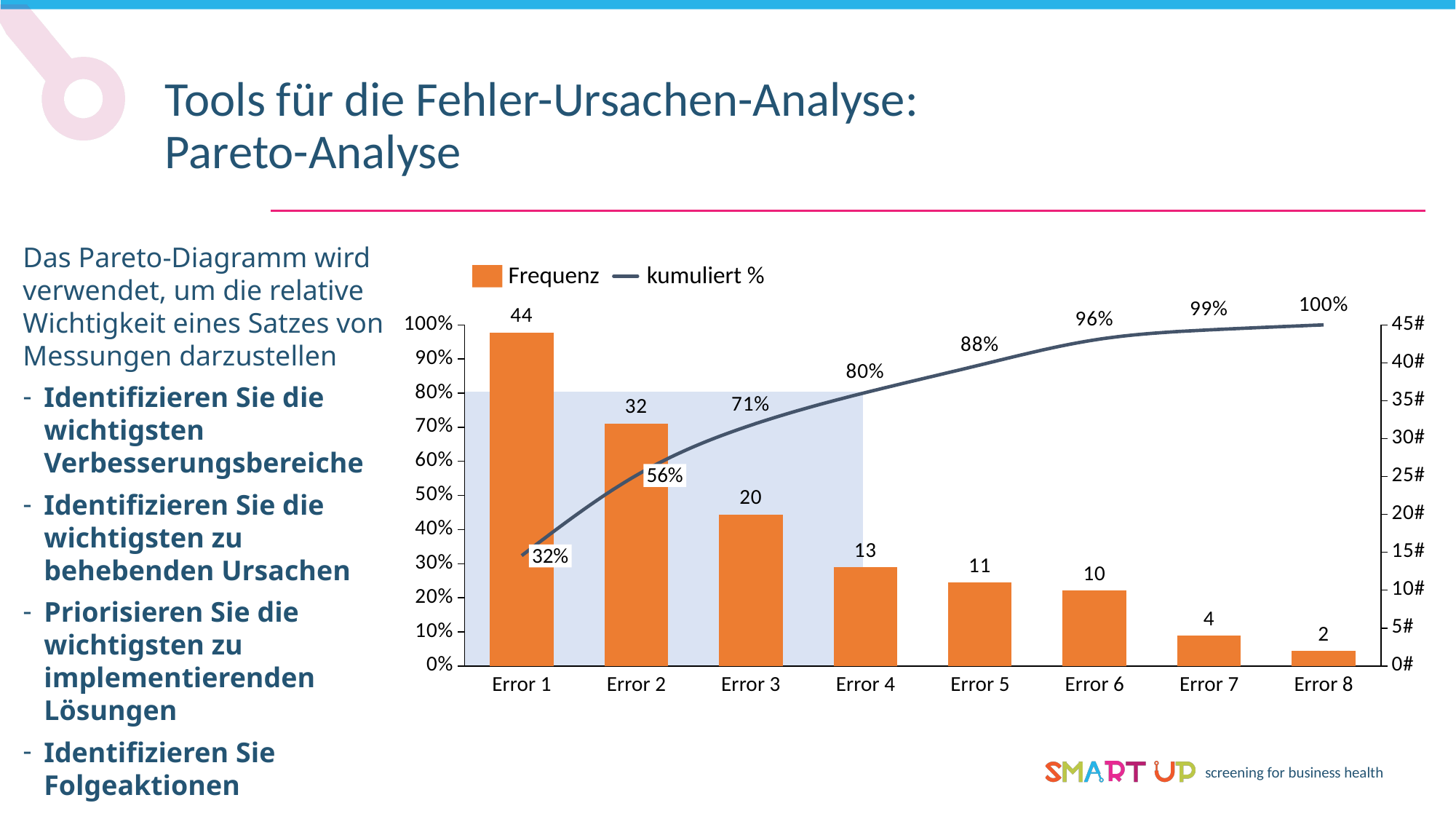
Which category has the highest Frequenz value? Error 1 What is the kumuliert % value at Error 4? 80% What kind of chart is shown on the slide? Combined bar and line chart How many categories are shown on the x axis? 8 Do the Frequenz values rise or fall from Error 1 to Error 8? Fall What is the Frequenz value for Error 6? 10 What are the two legend entries of the chart? Frequenz and kumuliert % Which has a larger Frequenz value, Error 3 or Error 5? Error 3 What is the difference between the Frequenz values for Error 1 and Error 2? 12 How many series does the legend list? 2 Which category has the lowest Frequenz value? Error 8 What is the Frequenz value for Error 1? 44